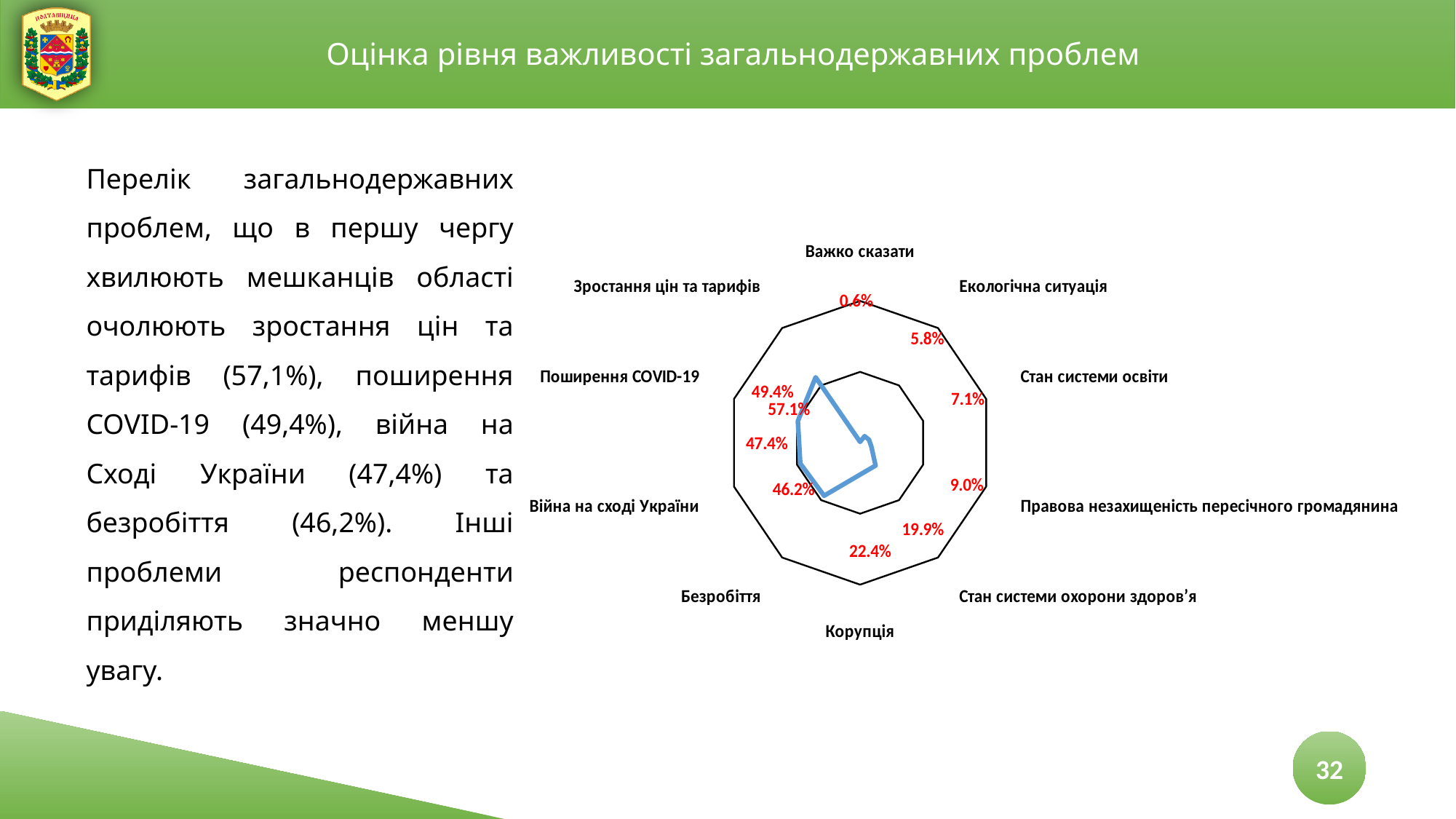
What is the value for Поширення COVID-19? 49.4% What is the value for Стан системи охорони здоров’я? 19.9% How many categories are plotted on the chart? 10 Which category has the highest value? Зростання цін та тарифів What is the difference between the values for Війна на сході України and Безробіття? 1.2% Which category has the lowest value? Важко сказати Which is larger, the value for Стан системи освіти or the value for Правова незахищеність пересічного громадянина? Правова незахищеність пересічного громадянина What is the title of the slide containing the chart? Оцінка рівня важливості загальнодержавних проблем What kind of chart is shown on the slide? radar chart What is the value for Зростання цін та тарифів? 57.1% What is the value for Корупція? 22.4% What is the value for Екологічна ситуація? 5.8%